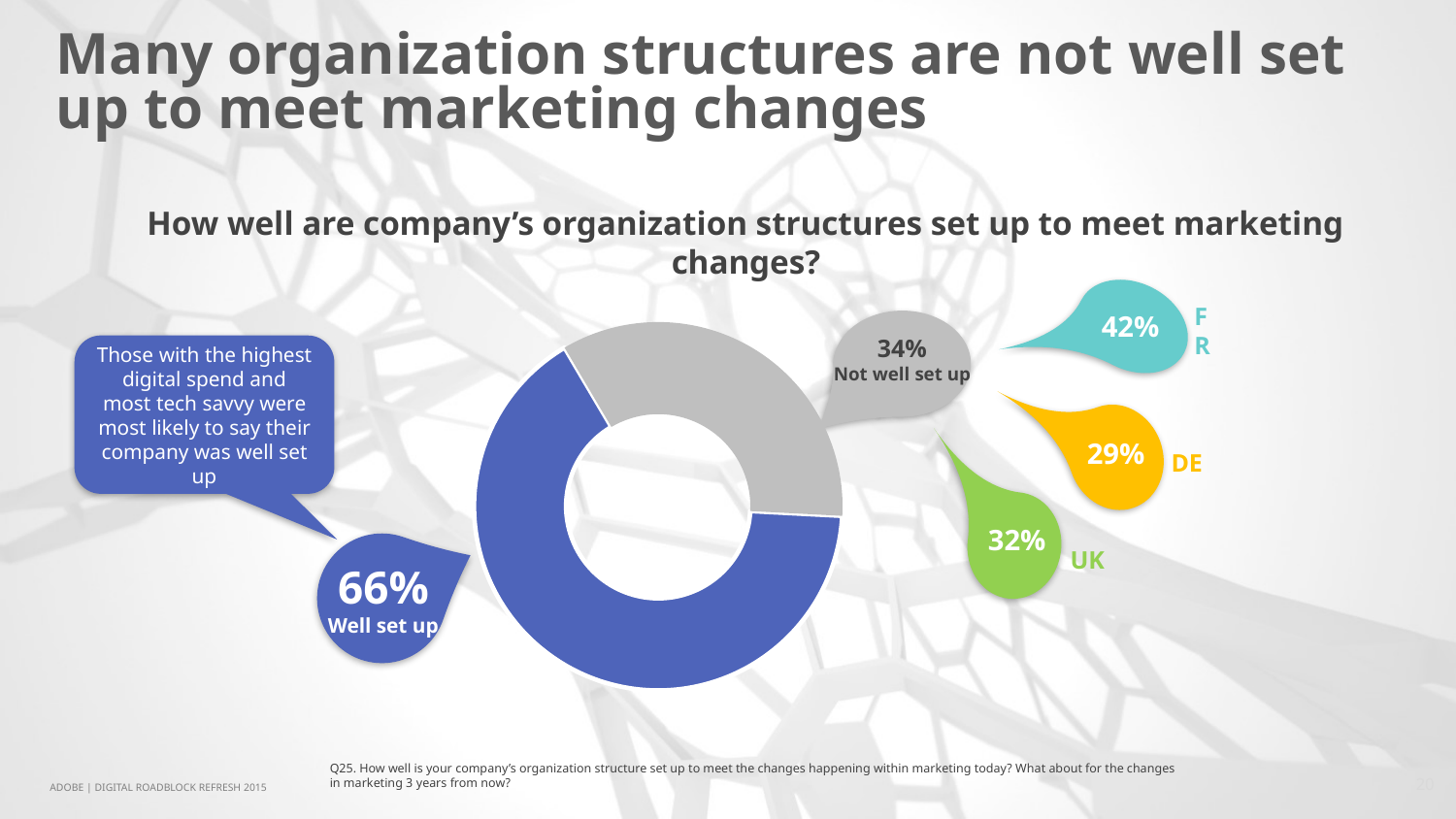
What is the difference in percentage points between 'Well set up' and 'Not well set up'? 32 percentage points Which country has the lowest 'Not well set up' percentage among FR, DE and UK? DE What is the 'Not well set up' percentage shown for UK? 32% What is the 'Not well set up' percentage shown for FR? 42% What percentage of respondents said their company's organization structure is well set up? 66% What percentage of respondents said their company's organization structure is not well set up? 34% Which slice of the donut chart is larger, 'Well set up' or 'Not well set up'? Well set up What is the 'Not well set up' percentage shown for DE? 29% Which country has the highest 'Not well set up' percentage among FR, DE and UK? FR What colour is the 'Well set up' slice of the donut chart? Blue How many slices does the donut chart have? 2 What kind of chart is shown on the slide? Donut chart